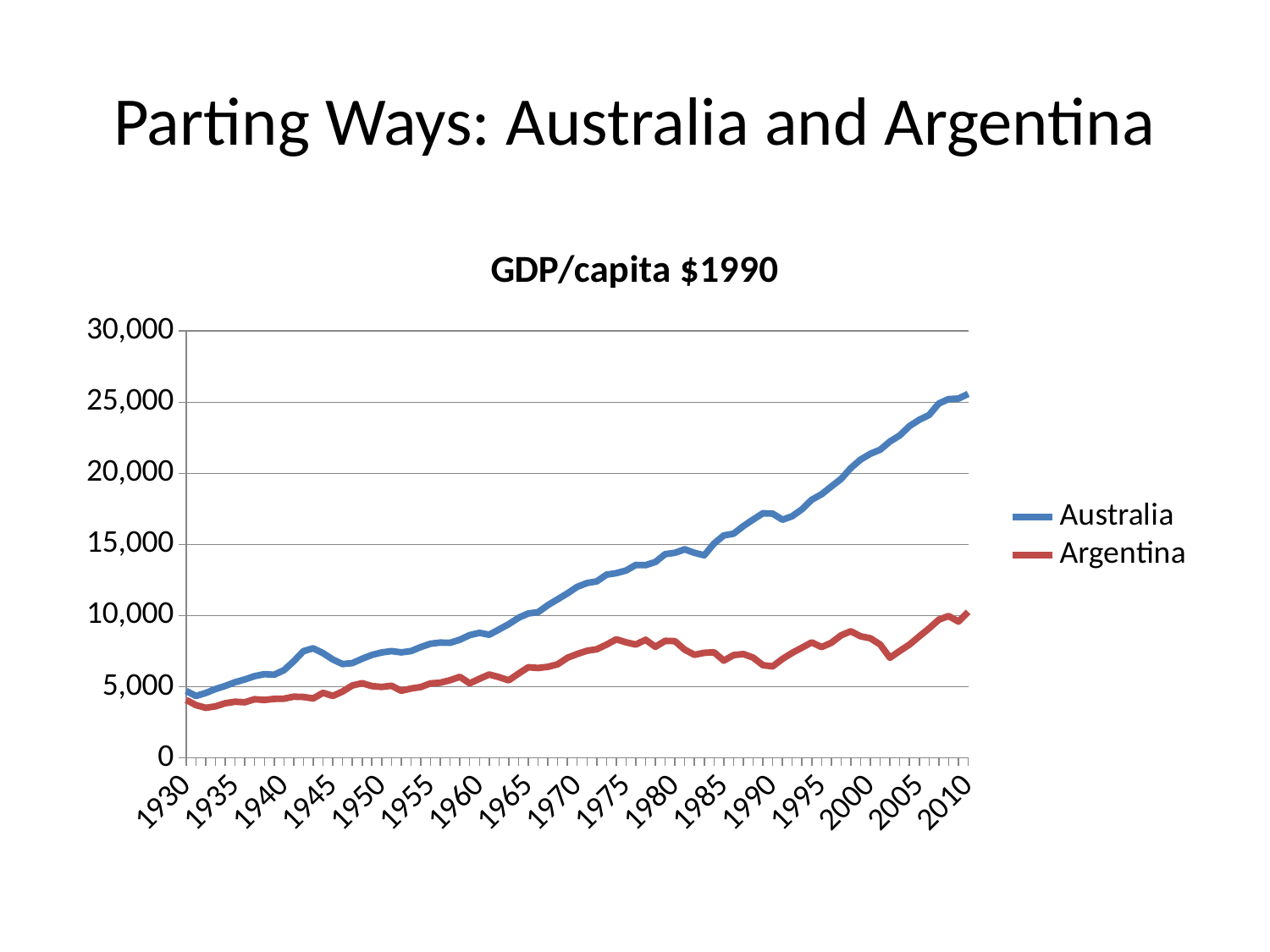
Which series reaches the highest value on the chart? Australia How many series does the legend list? 2 Is the value for Australia in 2010 greater or less than 20,000? greater What is the title of the chart? GDP/capita $1990 Is the value for Australia in 1970 greater or less than 10,000? greater Which series has the higher value in 2010, Australia or Argentina? Australia What kind of chart is shown on the slide? line chart Which two countries are listed in the legend? Australia and Argentina How many year labels are shown on the x axis? 17 Does the Australia series rise or fall overall from 1930 to 2010? rise Is the value for Argentina in 2010 greater or less than 15,000? less